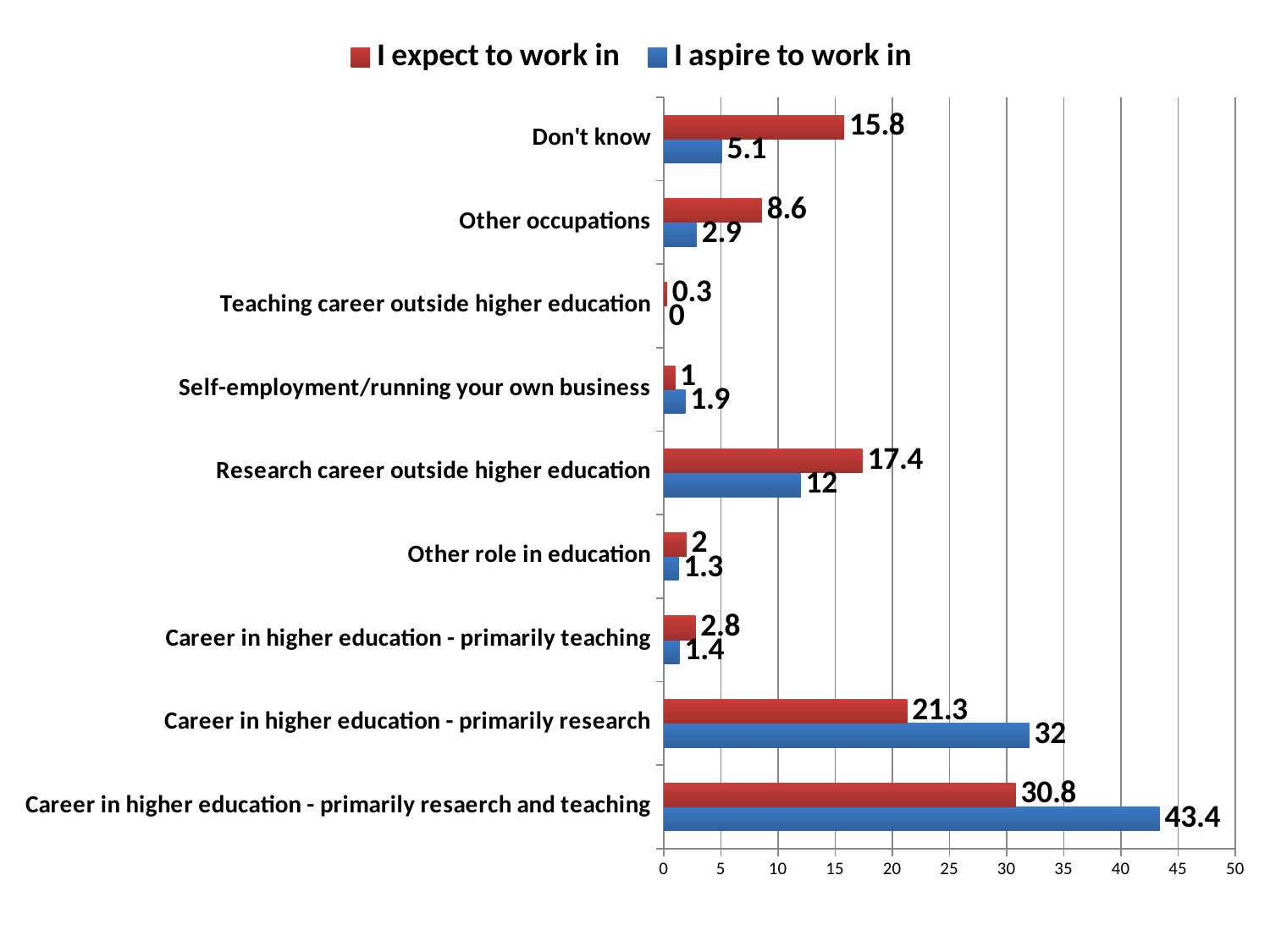
What is the 'I aspire to work in' value for Career in higher education - primarily research? 32 For Other occupations, which is larger: 'I expect to work in' or 'I aspire to work in'? I expect to work in Which category has the lowest 'I expect to work in' value? Teaching career outside higher education Is the 'I expect to work in' value for Career in higher education - primarily research greater or less than 25? less How many series does the legend list? 2 Which category has the highest 'I aspire to work in' value? Career in higher education - primarily resaerch and teaching What is the 'I expect to work in' value for Don't know? 15.8 What colour represents the 'I aspire to work in' series? blue What is the 'I expect to work in' value for Research career outside higher education? 17.4 What is the difference between the 'I aspire to work in' and 'I expect to work in' values for Career in higher education - primarily resaerch and teaching? 12.6 How many categories are shown on the chart? 9 What kind of chart is shown on the slide? bar chart